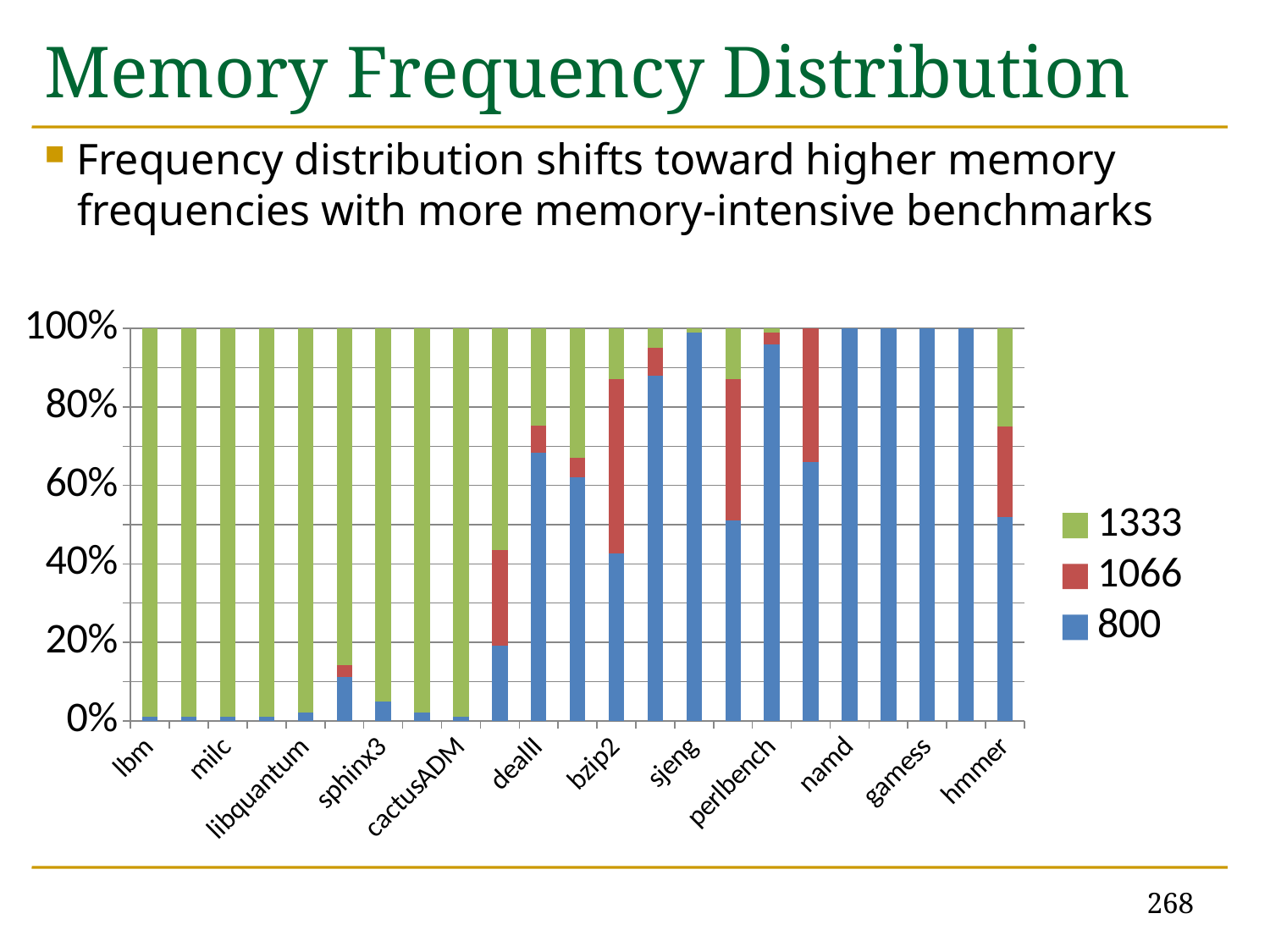
How many series does the legend list? 3 Is the 800 share for bzip2 greater or less than 60%? less Is the 800 share for lbm greater or less than 20%? less What is the total height of the stacked bar for gamess? 100% Is the 800 share for namd greater or less than 80%? greater Which has the larger 800 share, namd or lbm? namd What are the three series named in the legend? 1333, 1066, 800 What kind of chart is shown on the slide? stacked bar chart Which colour represents the 800 series in the chart? blue